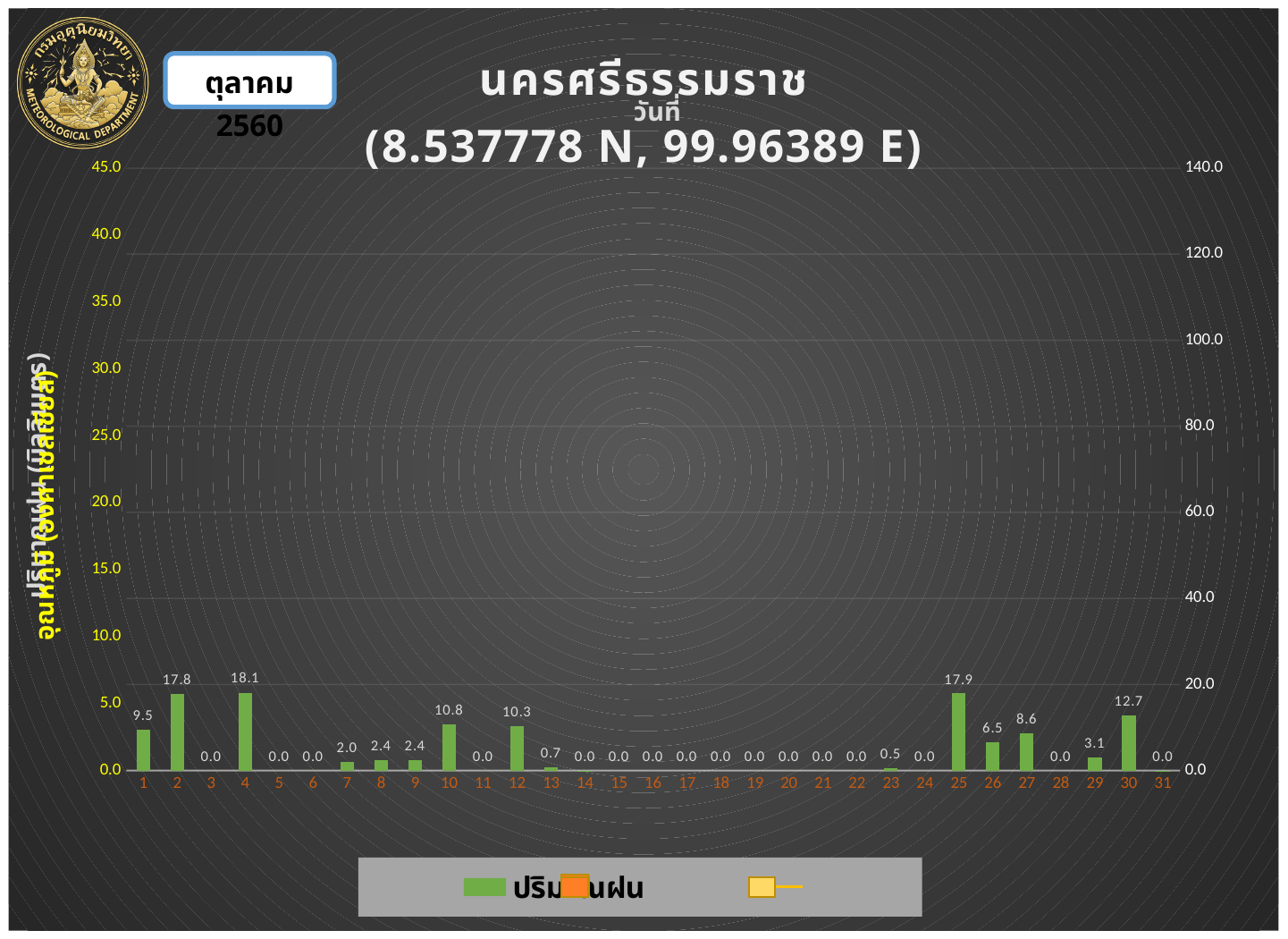
What is the rainfall value for day 30? 12.7 Which day has the highest rainfall value? 4 What is the station name shown in the chart title? นครศรีธรรมราช How many days are shown on the x axis of the chart? 31 What is the difference between the rainfall values for day 4 and day 2? 0.3 What is the rainfall value for day 4? 18.1 What is the difference between the rainfall values for day 27 and day 26? 2.1 Which is larger, the rainfall value for day 1 or for day 29? day 1 What is the rainfall value for day 25? 17.9 What is the rainfall value for day 10? 10.8 What kind of chart is shown on the slide? bar chart Which is larger, the rainfall value for day 10 or for day 12? day 10